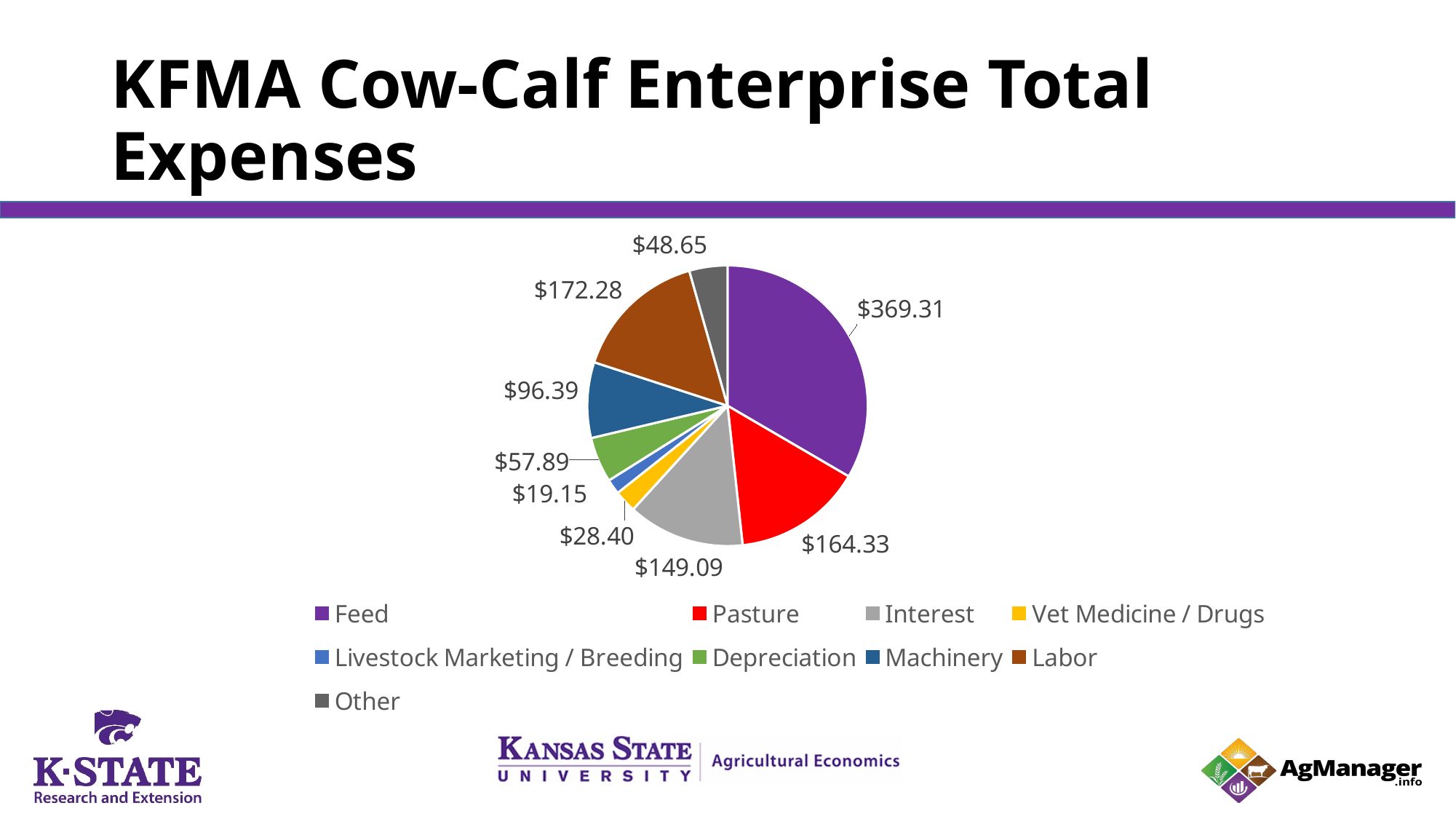
What is the value for Machinery? $96.39 What is the difference between the Machinery value and the Depreciation value? $38.50 What is the value for Feed? $369.31 What is the value for Vet Medicine / Drugs? $28.40 Which is larger, Pasture or Interest? Pasture Which expense category has the largest slice? Feed What is the value for Labor? $172.28 What colour represents Pasture in the pie chart? Red Which expense category has the smallest slice? Livestock Marketing / Breeding How many expense categories does the legend list? 9 What is the difference between the Feed value and the Labor value? $197.03 What type of chart is shown on the slide? Pie chart